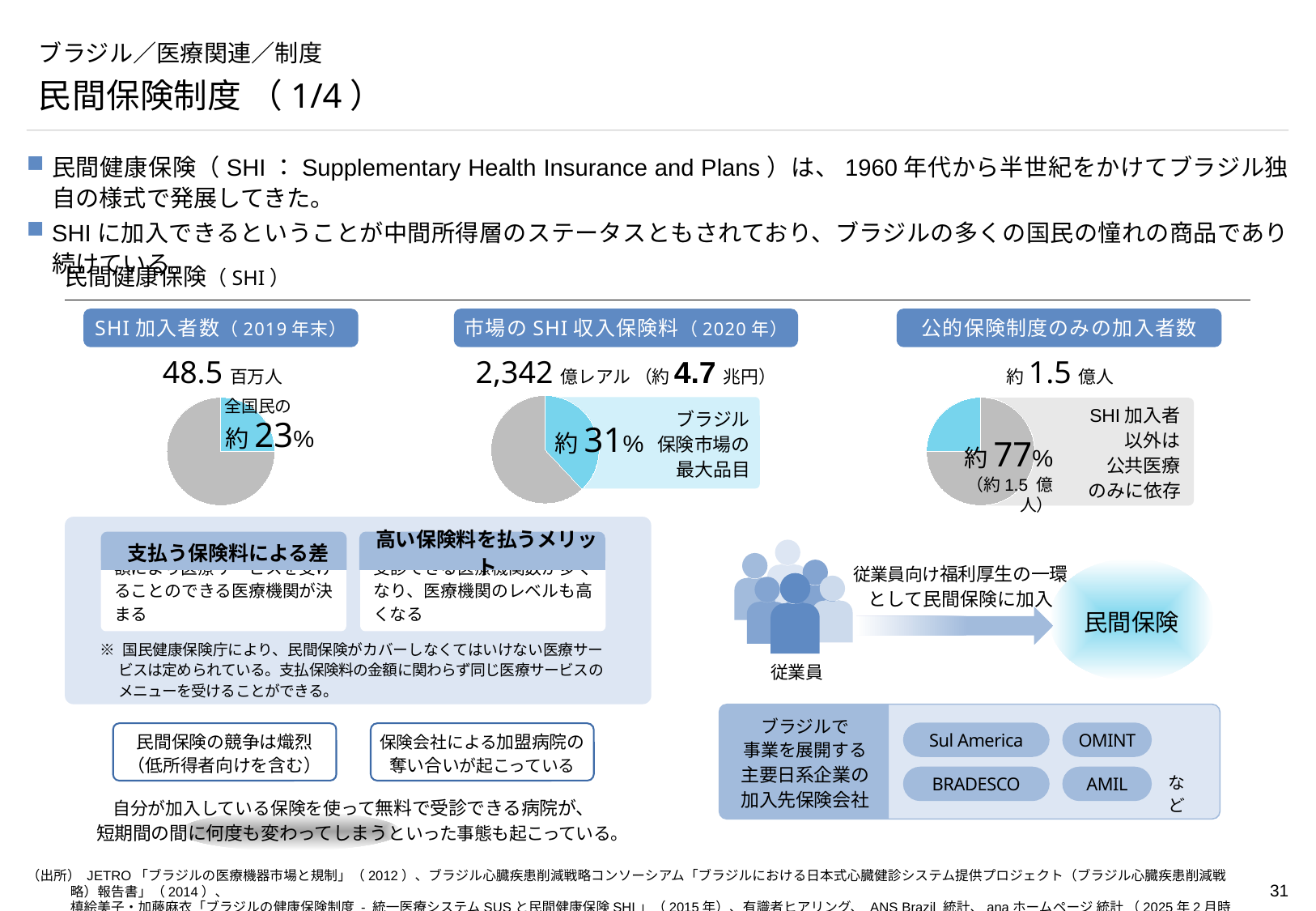
In the pie chart under 'SHI加入者数（2019年末）', what share of the whole population is highlighted? 約23% In the pie chart under '市場のSHI収入保険料（2020年）', what share is highlighted? 約31% What kind of chart is used under the heading 'SHI加入者数（2019年末）'? pie chart What value is printed above the pie chart under '公的保険制度のみの加入者数'? 約1.5億人 What colour is used for the highlighted slice in the three pie charts? light blue Is the highlighted share in the '市場のSHI収入保険料（2020年）' pie chart larger or smaller than the highlighted share in the 'SHI加入者数（2019年末）' pie chart? larger What value is printed above the pie chart under '市場のSHI収入保険料（2020年）'? 2,342億レアル What value is printed above the pie chart under 'SHI加入者数（2019年末）'? 48.5百万人 In the pie chart under '公的保険制度のみの加入者数', what share is highlighted? 約77% How many pie charts are shown on the slide? 3